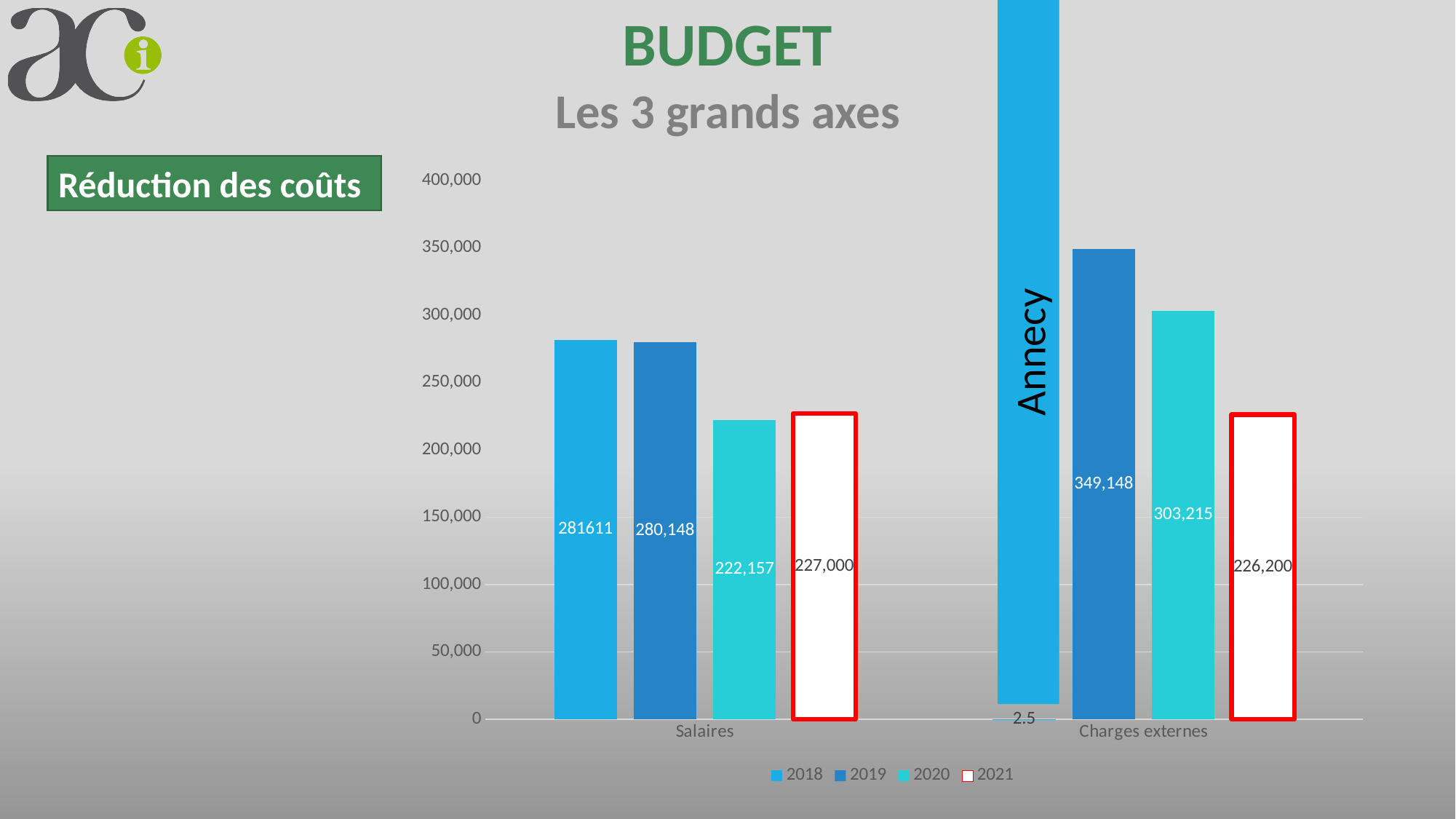
What is the 2020 value for Charges externes? 303,215 Which is larger in 2019: Salaires or Charges externes? Charges externes What is the 2018 value for Salaires? 281611 What is the 2021 value for Salaires? 227,000 What is the 2021 value for Charges externes? 226,200 What is the difference between the 2019 and 2020 values for Charges externes? 45,933 What is the difference between the 2021 and 2020 values for Salaires? 4,843 What kind of chart is shown on the slide? bar chart How many series does the legend list? 4 What is the 2019 value for Salaires? 280,148 How many categories are shown on the x axis? 2 Is the 2020 value for Salaires greater or less than 250,000? less